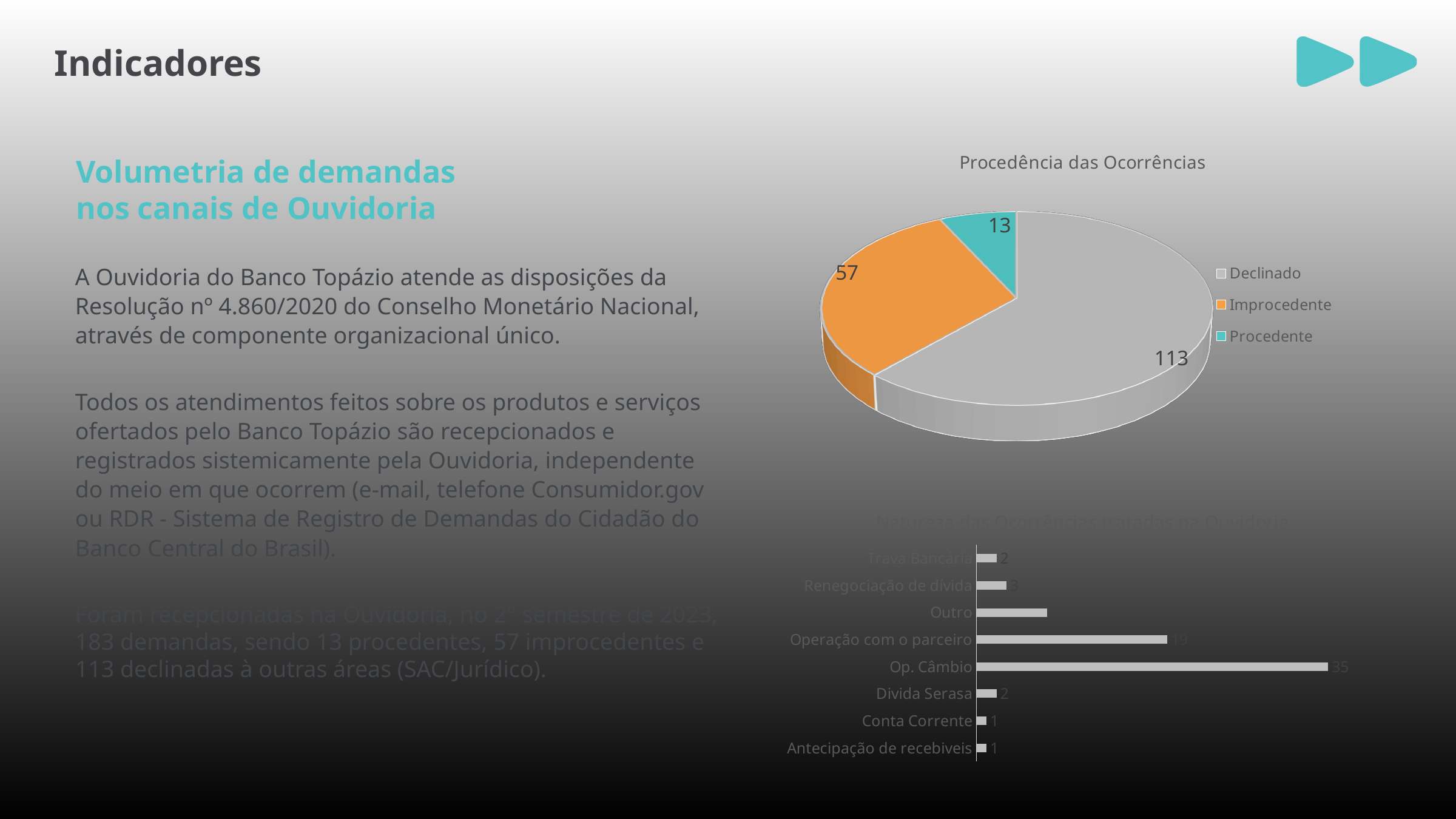
In the pie chart titled "Procedência das Ocorrências", what is the value for Improcedente? 57 In the bar chart at the bottom right of the slide, which category has the longest bar? Op. Câmbio In the bar chart at the bottom right of the slide, what is the value for Op. Câmbio? 35 In the bar chart at the bottom right of the slide, what is the value for Operação com o parceiro? 19 In the pie chart titled "Procedência das Ocorrências", which category has the largest slice? Declinado What type of chart is the chart titled "Procedência das Ocorrências"? Pie chart In the pie chart titled "Procedência das Ocorrências", what is the value for Declinado? 113 How many entries does the legend of the pie chart titled "Procedência das Ocorrências" list? 3 In the pie chart titled "Procedência das Ocorrências", what is the difference between the Declinado and Improcedente values? 56 In the pie chart titled "Procedência das Ocorrências", what is the value for Procedente? 13 How many categories are shown in the bar chart at the bottom right of the slide? 8 In the pie chart titled "Procedência das Ocorrências", which category has the smallest slice? Procedente